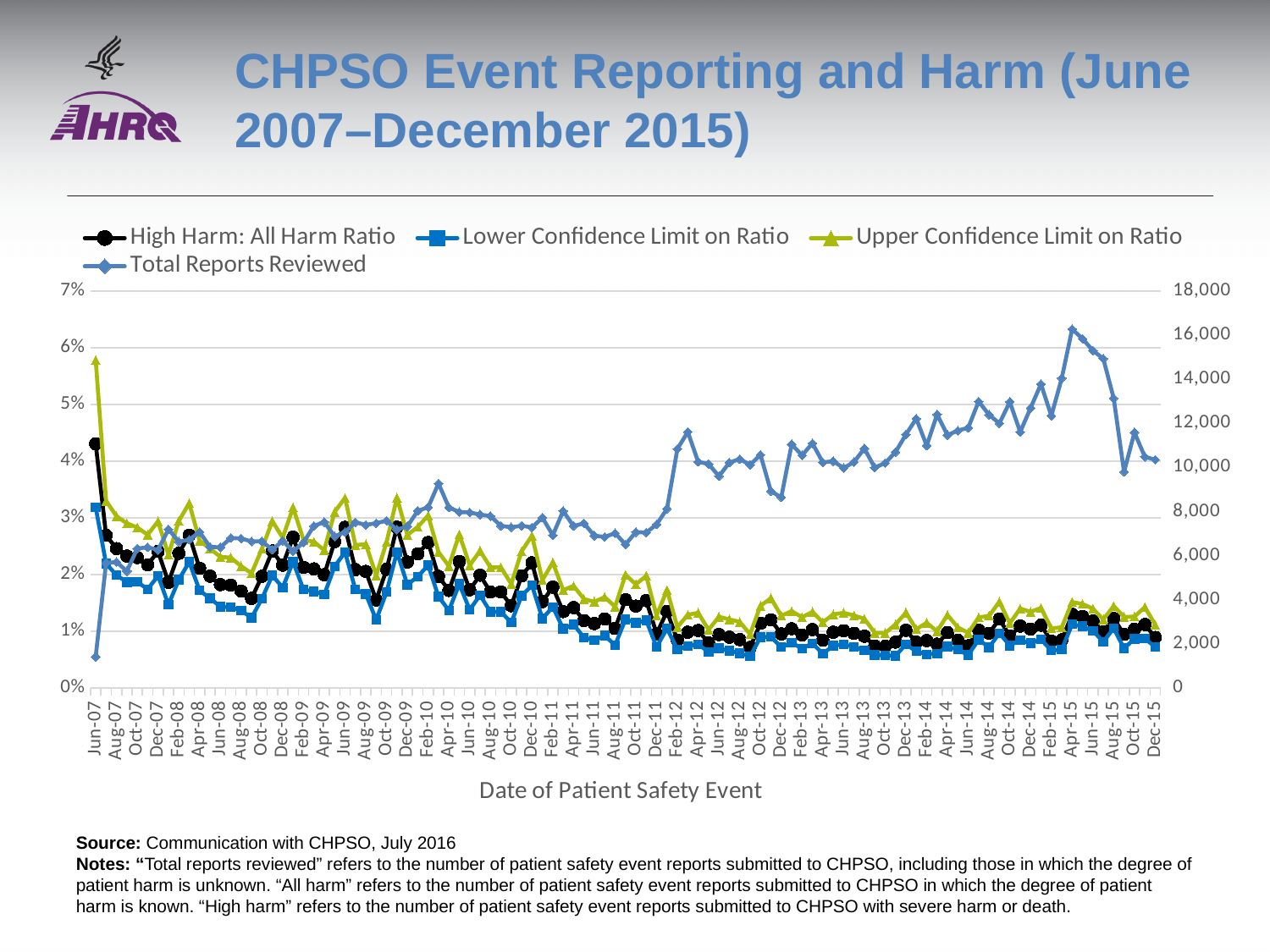
How many series does the legend list? 4 Which of the three ratio series is highest throughout the chart? Upper Confidence Limit on Ratio Is the High Harm: All Harm Ratio in Jun-07 greater or less than 3%? greater What is the title of the chart's x axis? Date of Patient Safety Event What kind of chart is shown on the slide? Line chart Does the High Harm: All Harm Ratio generally rise or fall from Jun-07 to Dec-15? fall Is the value for Total Reports Reviewed in Apr-15 greater or less than 14,000? greater Which series is plotted with green triangle markers? Upper Confidence Limit on Ratio Is the value for Total Reports Reviewed in Jun-07 greater or less than 2,000? less Does Total Reports Reviewed generally rise or fall from Jun-07 to Apr-15? rise